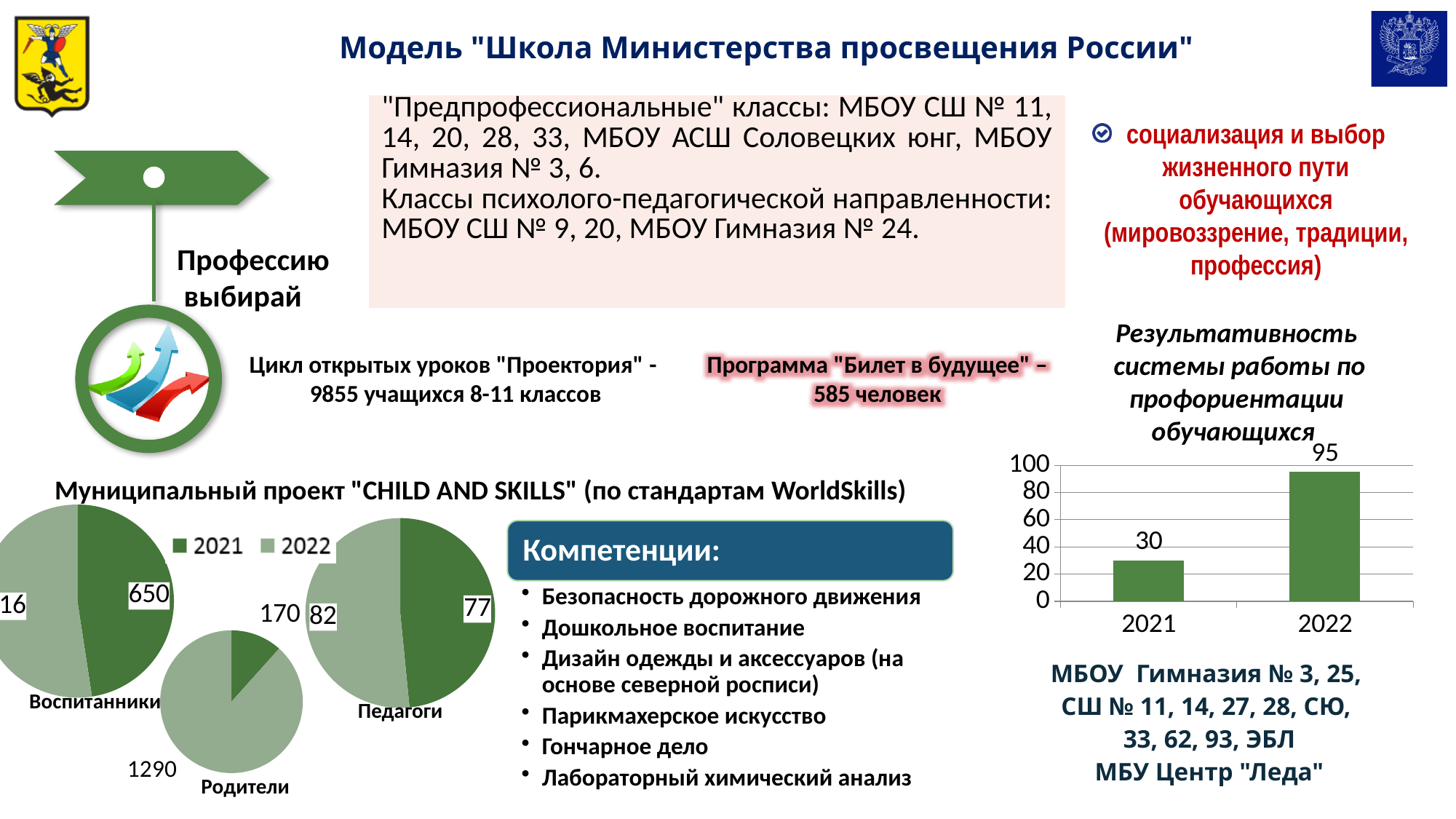
In the pie chart labelled "Родители", what is the value for 2021? 170 In the pie chart labelled "Родители", what is the value for 2022? 1290 In the pie chart labelled "Педагоги", which year has the larger value, 2021 or 2022? 2022 In the bar chart titled "Результативность системы работы по профориентации обучающихся", do the values rise or fall from 2021 to 2022? rise How many series does the legend of the pie charts under "Муниципальный проект "CHILD AND SKILLS"" list? 2 In the bar chart titled "Результативность системы работы по профориентации обучающихся", what is the value for 2021? 30 In the bar chart titled "Результативность системы работы по профориентации обучающихся", what is the value for 2022? 95 In the bar chart titled "Результативность системы работы по профориентации обучающихся", which year has the higher value? 2022 In the bar chart titled "Результативность системы работы по профориентации обучающихся", what is the difference between the 2022 and 2021 values? 65 In the pie chart labelled "Педагоги", what is the value for 2022? 82 How many categories are shown on the x axis of the bar chart titled "Результативность системы работы по профориентации обучающихся"? 2 What kind of chart is the chart titled "Результативность системы работы по профориентации обучающихся"? bar chart